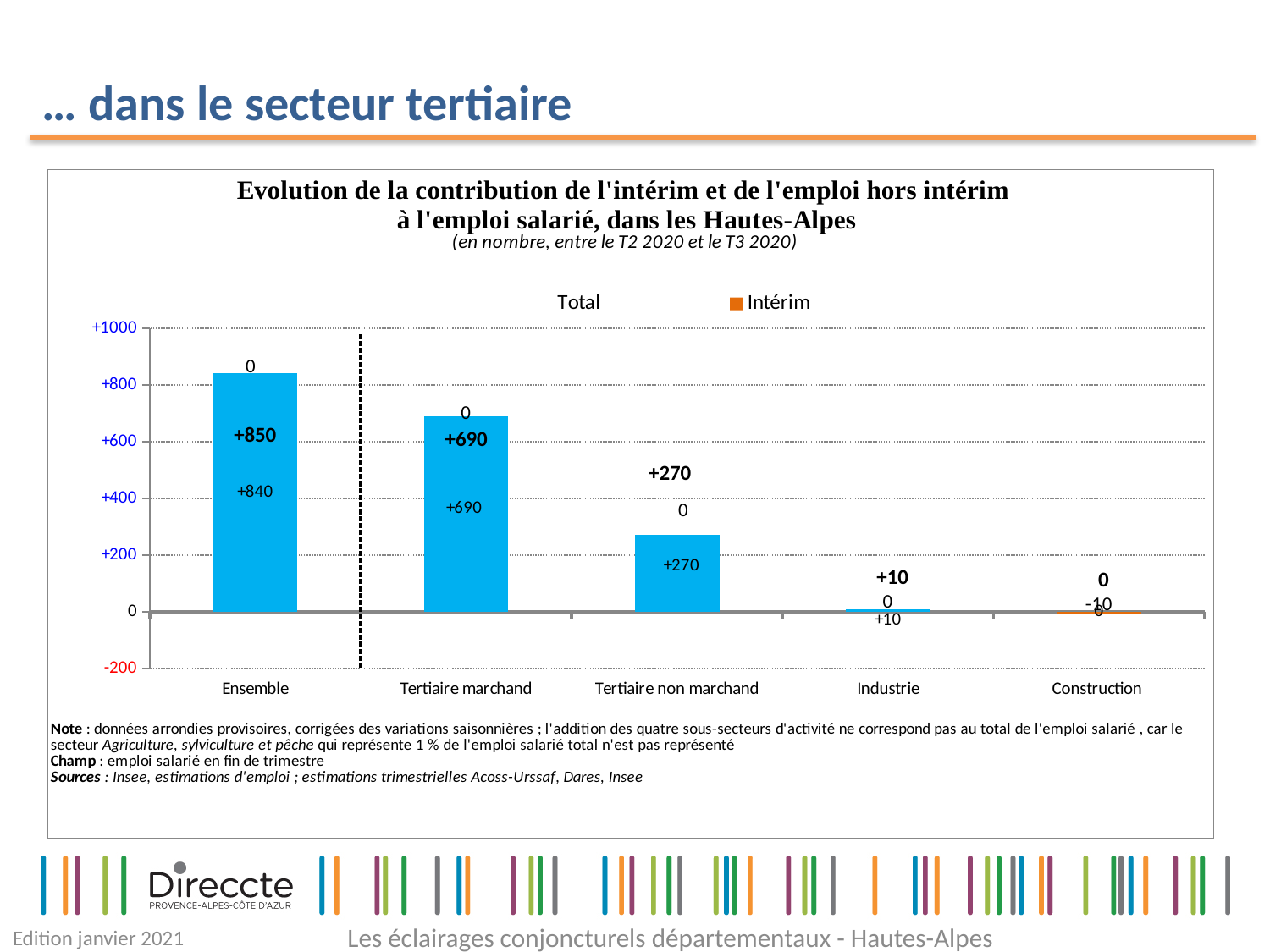
Which is larger, the blue bar for Tertiaire marchand or for Tertiaire non marchand? Tertiaire marchand How many series does the chart legend list? 2 What kind of chart is shown on the slide? bar chart What is the bold total value shown for Industrie? +10 How many categories are shown along the x axis of the chart? 5 Which category has the lowest blue bar? Construction What value is printed on the blue bar for Tertiaire non marchand? +270 What is the bold total value shown for Tertiaire marchand? +690 What value is printed on the blue bar for Construction? 0 What value is printed on the blue bar for Ensemble? +840 Which category has the highest blue bar? Ensemble What is the difference between the blue bar values for Ensemble (+840) and Tertiaire marchand (+690)? 150